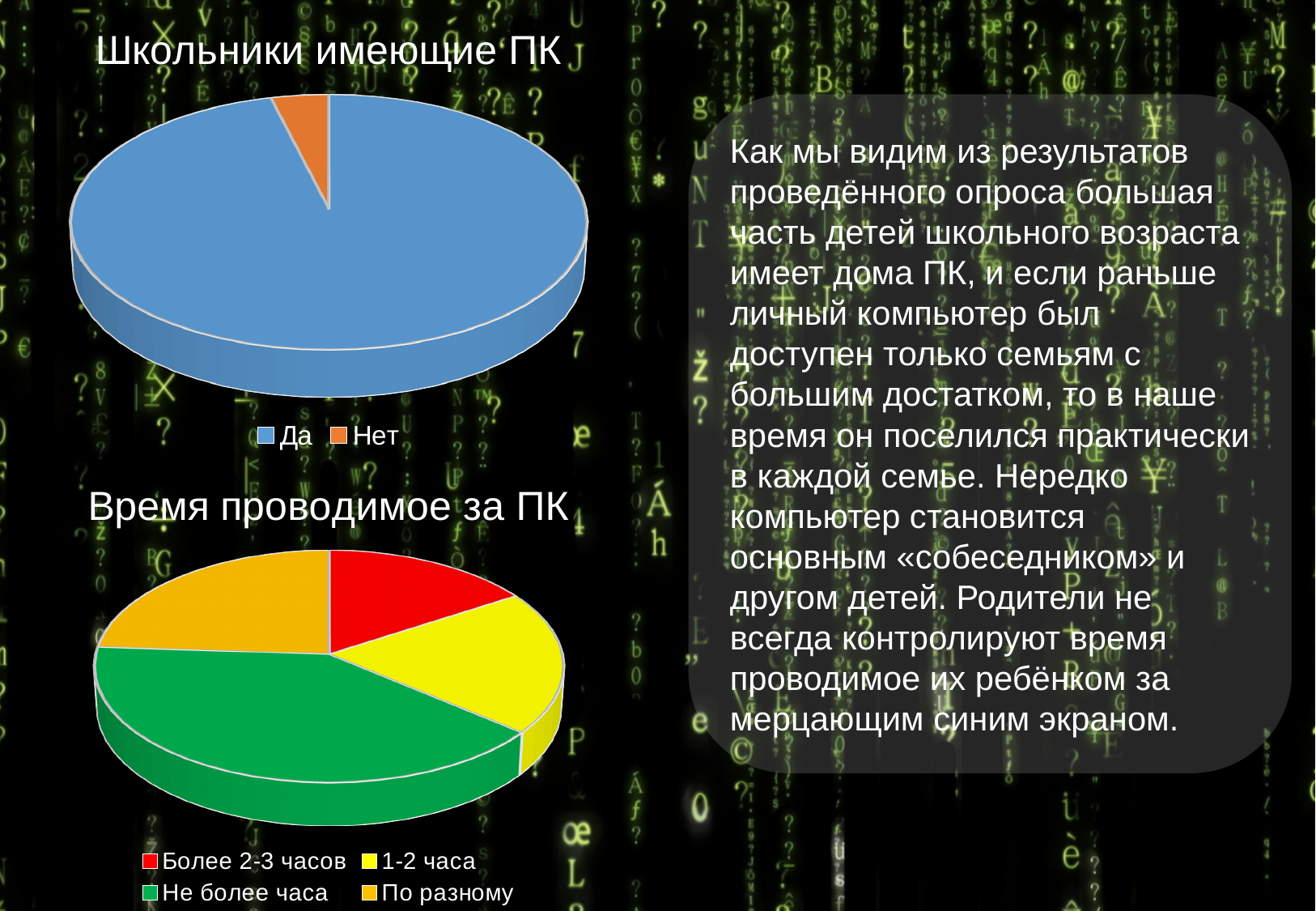
In the chart "Школьники имеющие ПК", what colour is the slice for "Нет"? orange In the chart "Время проводимое за ПК", what colour is the slice for "1-2 часа"? yellow In the chart "Школьники имеющие ПК", which category has the largest slice? Да In the chart "Время проводимое за ПК", which slice is larger: "По разному" or "Более 2-3 часов"? По разному How many categories does the chart "Время проводимое за ПК" show? 4 What kind of chart is the chart titled "Школьники имеющие ПК"? pie chart In the chart "Время проводимое за ПК", which slice is larger: "Не более часа" or "1-2 часа"? Не более часа In the chart "Школьники имеющие ПК", which category has the smallest slice? Нет In the chart "Время проводимое за ПК", which category has the smallest slice? Более 2-3 часов In the chart "Время проводимое за ПК", which category has the largest slice? Не более часа What kind of chart is the chart titled "Время проводимое за ПК"? pie chart How many categories does the chart "Школьники имеющие ПК" show? 2